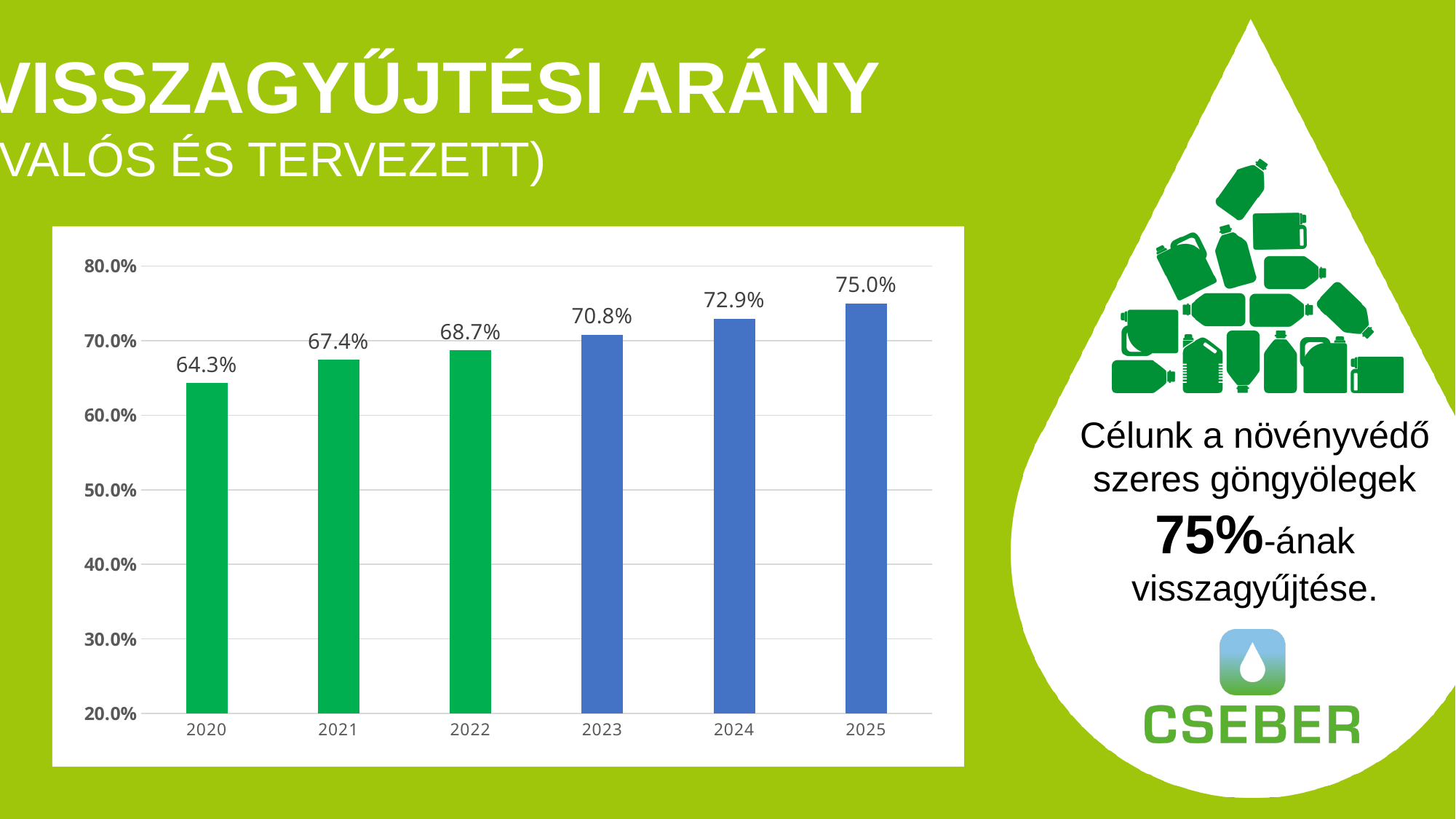
Is the value for 2021 greater or less than 70.0%? less What kind of chart is shown on the slide? bar chart Which year has the lowest value? 2020 What is the value for 2023? 70.8% What is the value for 2025? 75.0% What is the difference between the values for 2025 and 2020? 10.7% What is the value for 2020? 64.3% Do the values rise or fall from 2020 to 2025? rise Which year has the highest value? 2025 Which is larger, the value for 2024 or the value for 2022? 2024 What is the difference between the values for 2022 and 2021? 1.3% How many years are shown on the x axis? 6